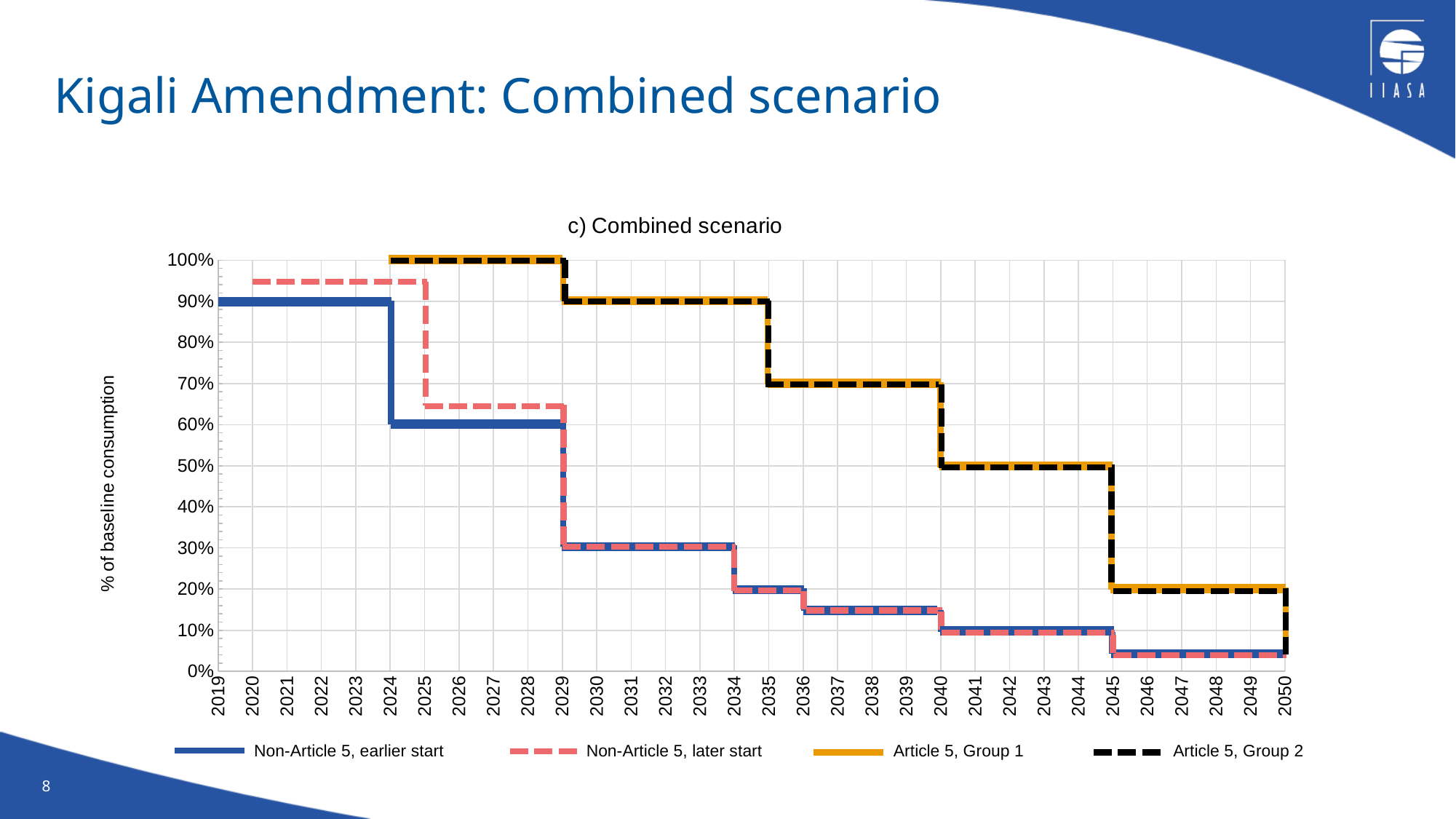
What is the value for Article 5, Group 2 in 2043? 50% What is the value for Non-Article 5, earlier start in 2027? 60% What is the value for Non-Article 5, earlier start in 2021? 90% What is the value for Article 5, Group 1 in 2047? 20% What is the title of the chart? c) Combined scenario What is the label of the vertical axis? % of baseline consumption In 2030, which is larger: the value for Article 5, Group 1 or the value for Non-Article 5, earlier start? Article 5, Group 1 How many series does the legend list? 4 Is the value for Non-Article 5, later start in 2020 greater or less than 90%? greater Do the values for Non-Article 5, earlier start rise or fall from 2019 to 2050? fall What is the value for Article 5, Group 1 in 2027? 100% What kind of chart is shown on the slide? line chart